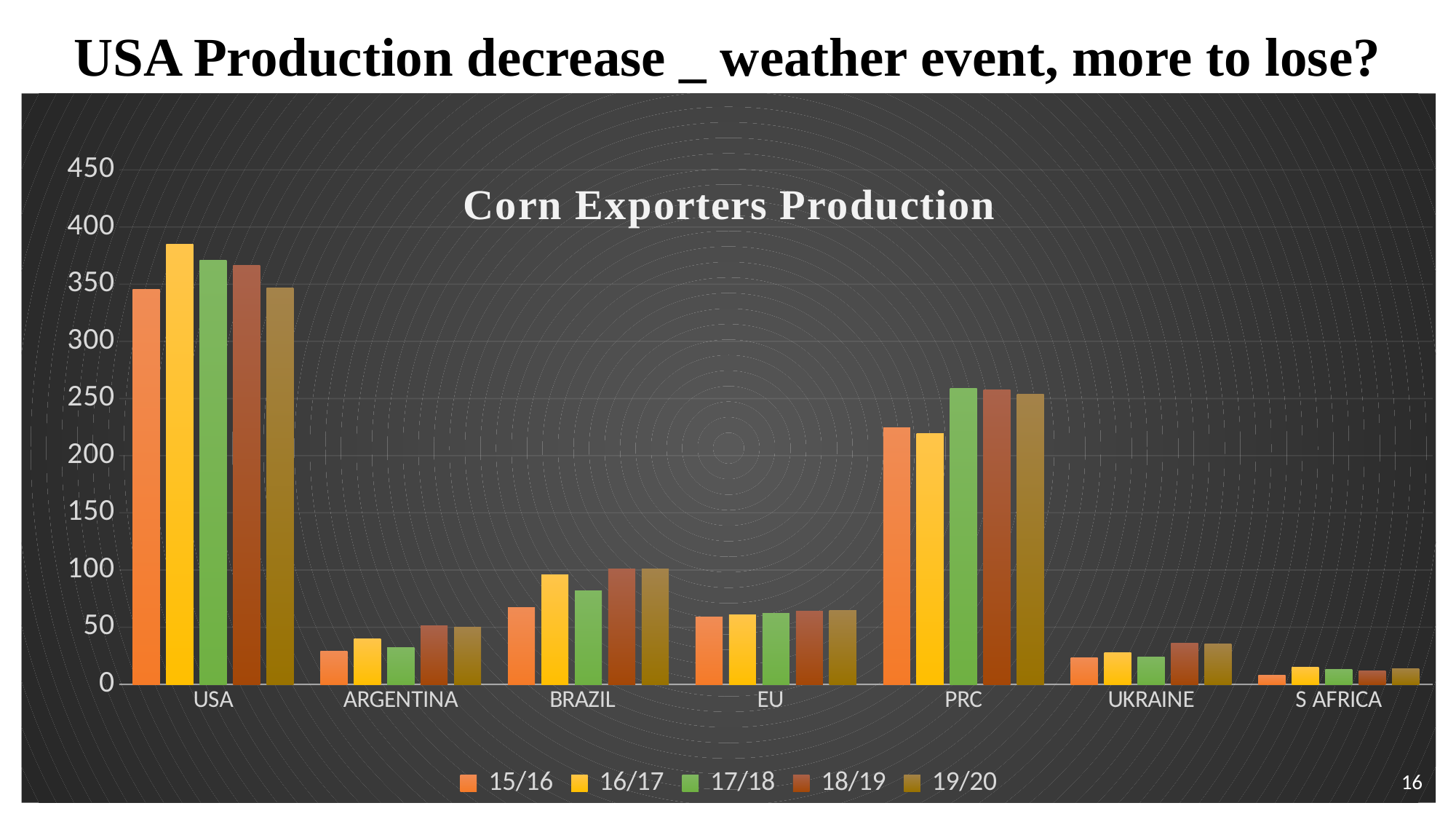
Which is larger in 16/17: Brazil or Argentina? Brazil For USA, does production rise or fall from 16/17 to 19/20? fall What kind of chart is shown on the slide? bar chart Which is larger in 17/18: USA or PRC? USA How many series does the legend list? 5 Is the value for PRC in 15/16 greater or less than 250? less Which country has the highest corn production in 16/17? USA Is the value for EU in 19/20 greater or less than 100? less Is the value for USA in 16/17 greater or less than 350? greater How many countries/regions are shown on the x axis? 7 Which country has the lowest corn production in 15/16? S AFRICA What is the title of the chart? Corn Exporters Production